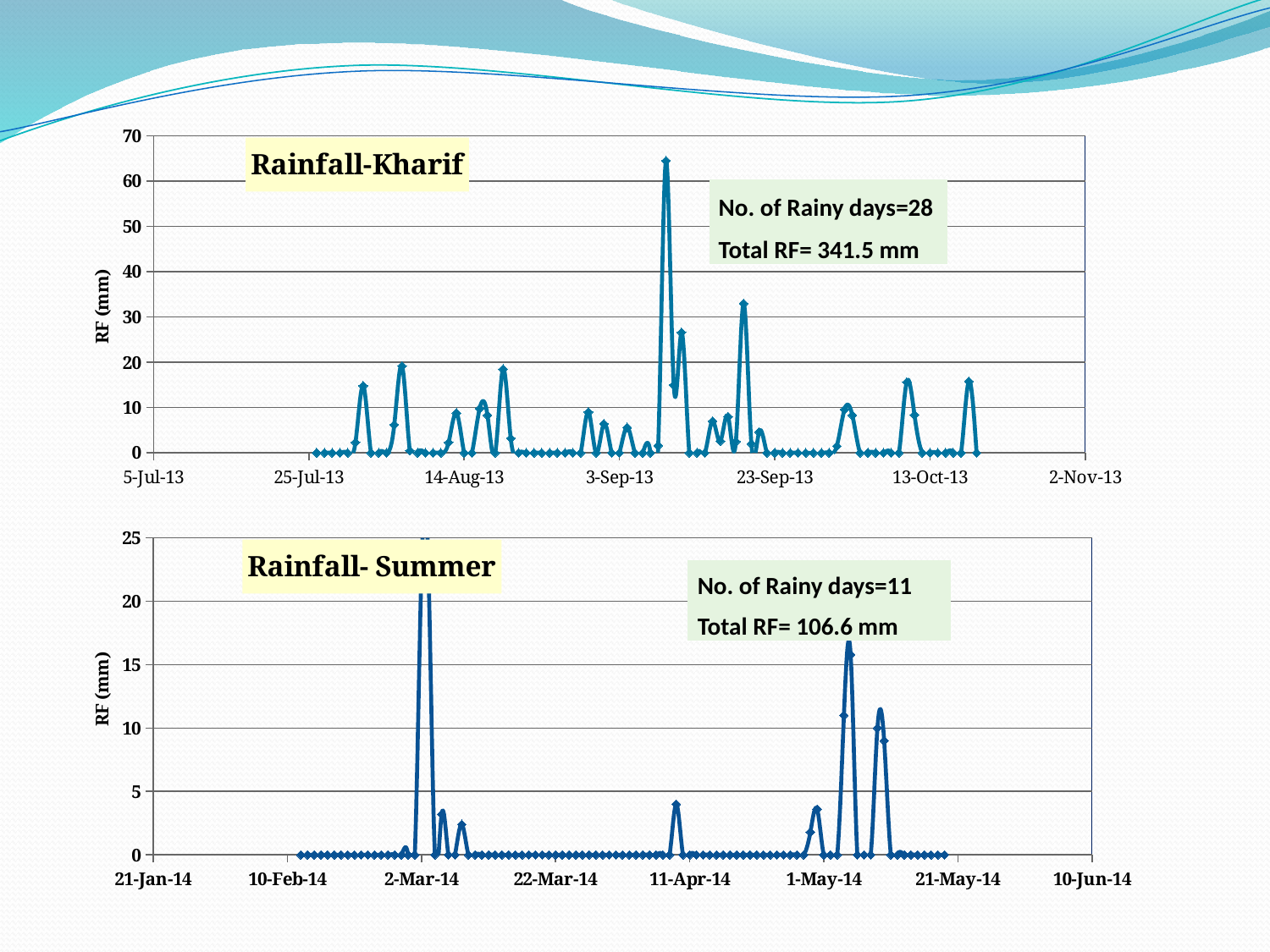
What is the title of the lower chart on the slide? Rainfall- Summer On the Rainfall- Summer chart, what is the number of rainy days stated? 11 On the Rainfall- Summer chart, what is the total RF stated? 106.6 mm On the Rainfall-Kharif chart, is the peak just before 23-Sep-13 greater or less than 30 mm? greater On the Rainfall- Summer chart, is the peak just after 1-May-14 greater or less than 15 mm? greater On the Rainfall-Kharif chart, is the highest rainfall peak (shortly after 3-Sep-13) greater or less than 60 mm? greater On the Rainfall-Kharif chart, what is the number of rainy days stated? 28 Which chart reports more rainy days, Rainfall-Kharif or Rainfall- Summer? Rainfall-Kharif What kind of chart is the Rainfall-Kharif chart? Line chart What is the y-axis label on the Rainfall-Kharif chart? RF (mm) On the Rainfall-Kharif chart, what is the total RF stated? 341.5 mm